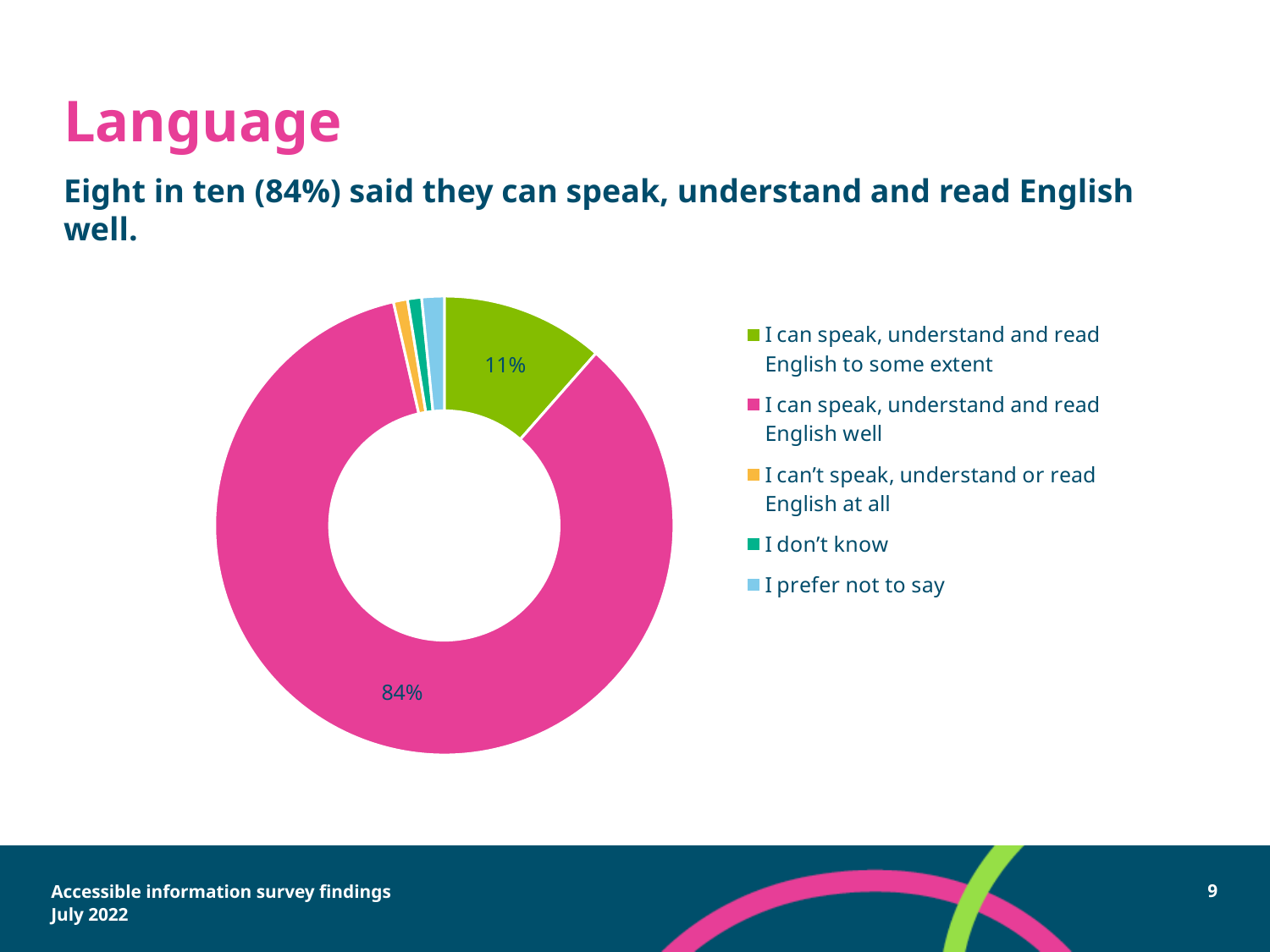
Which is larger: the share for 'I can speak, understand and read English to some extent' or the share for 'I prefer not to say'? I can speak, understand and read English to some extent Which category has the largest share of the chart? I can speak, understand and read English well What percentage of respondents said they can speak, understand and read English well? 84% What is the difference in percentage points between 'I can speak, understand and read English well' and 'I can speak, understand and read English to some extent'? 73 Is the share for 'I can't speak, understand or read English at all' greater or less than 10%? less How many categories does the legend list? 5 What kind of chart is shown on the slide? Doughnut (pie) chart What percentage of respondents said they can speak, understand and read English to some extent? 11% What colour represents 'I can speak, understand and read English well' in the chart? Pink Which is larger: the share for 'I can speak, understand and read English well' or the share for 'I can speak, understand and read English to some extent'? I can speak, understand and read English well Is the share for 'I can speak, understand and read English well' greater or less than 50%? greater What colour represents 'I don't know' in the chart? Green (teal)